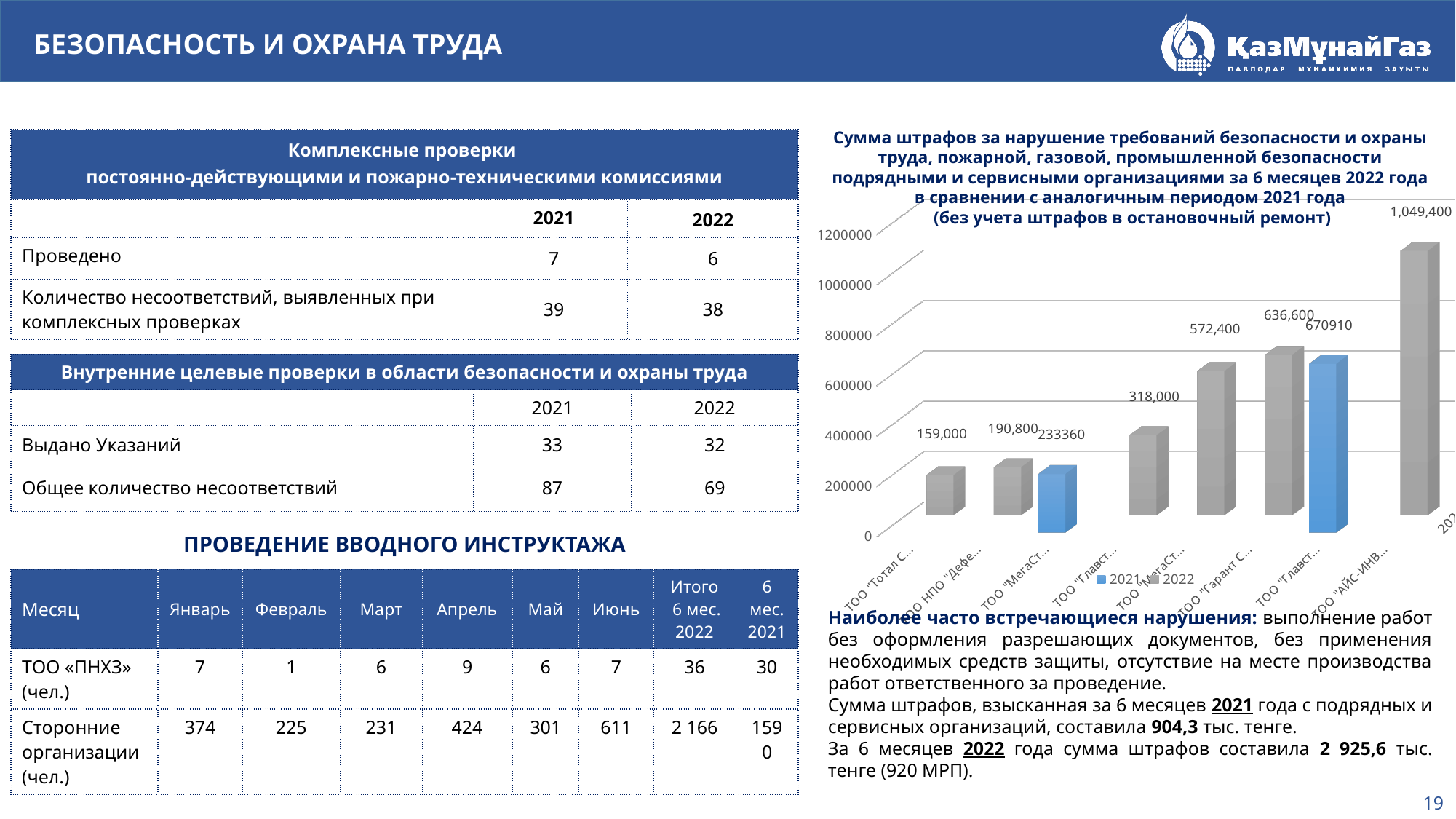
What is the difference between the highest and lowest labelled values in the bar chart? 890,400 Which years are listed in the legend of the bar chart? 2021 and 2022 How many bars are plotted in the bar chart? 8 What are the two values labelled on the blue (2021) bars in the bar chart? 233360 and 670910 In the bar chart, which colour represents the 2021 series? blue What is the lowest value labelled in the bar chart? 159,000 What is the difference between the two blue (2021) bars in the bar chart? 437550 What kind of chart is shown on the right side of the slide? bar chart Is the value of the rightmost bar in the bar chart greater or less than 1000000? greater Is the value of the leftmost bar in the bar chart greater or less than 200000? less What is the highest value labelled in the bar chart? 1,049,400 How many series does the legend of the bar chart list? 2